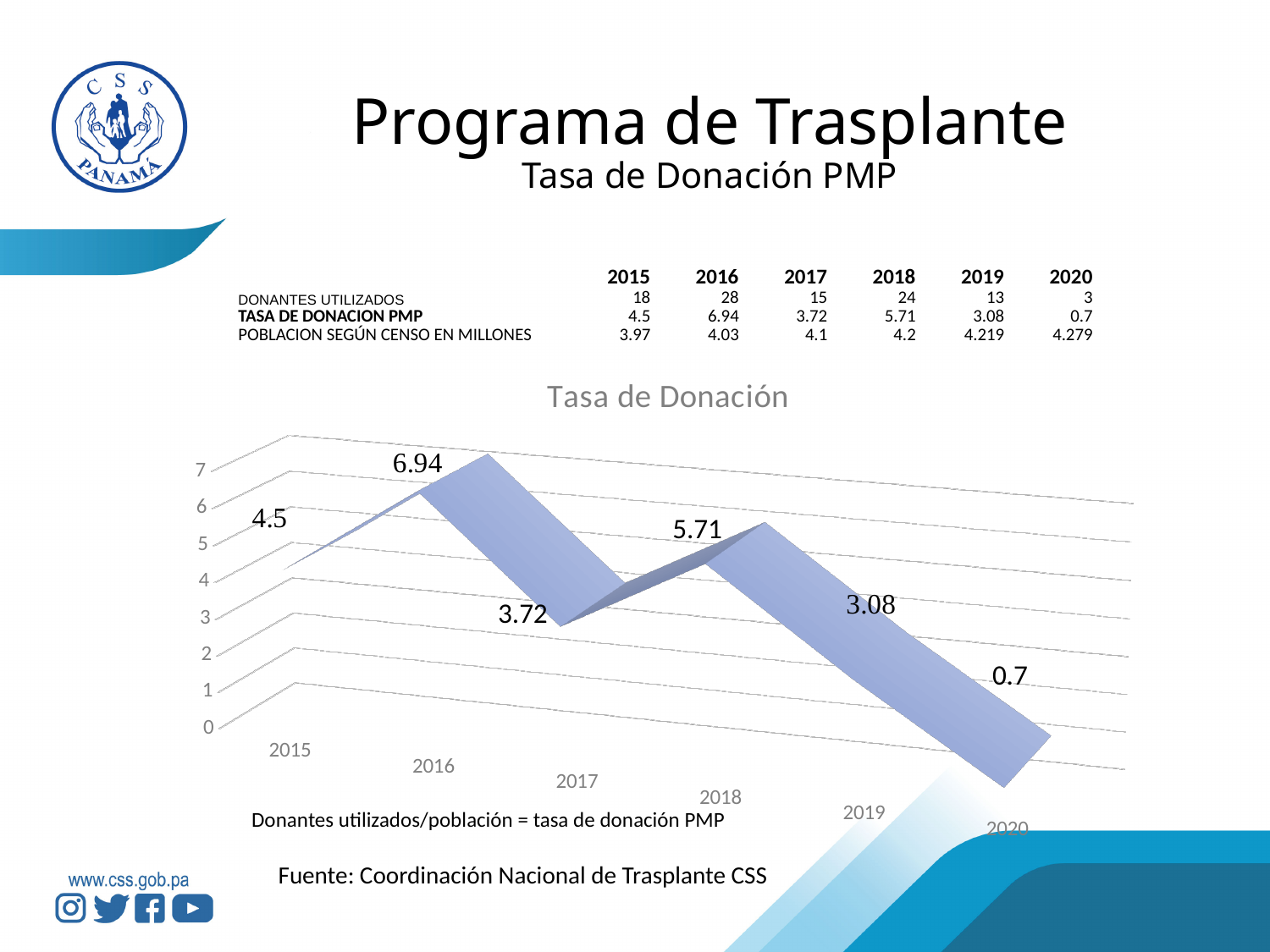
What is the difference between the values for 2016 and 2017 in the Tasa de Donación chart? 3.22 How many years are plotted in the Tasa de Donación chart? 6 Is the value for 2017 in the Tasa de Donación chart greater or less than 4? less Which year has the highest value in the Tasa de Donación chart? 2016 What is the title of the chart? Tasa de Donación Does the value in the Tasa de Donación chart rise or fall from 2018 to 2020? fall Which is larger in the Tasa de Donación chart, the value for 2015 or the value for 2018? 2018 What type of chart is shown on the slide? line chart What is the value for 2016 in the Tasa de Donación chart? 6.94 What is the value for 2019 in the Tasa de Donación chart? 3.08 Which year has the lowest value in the Tasa de Donación chart? 2020 What is the value for 2020 in the Tasa de Donación chart? 0.7